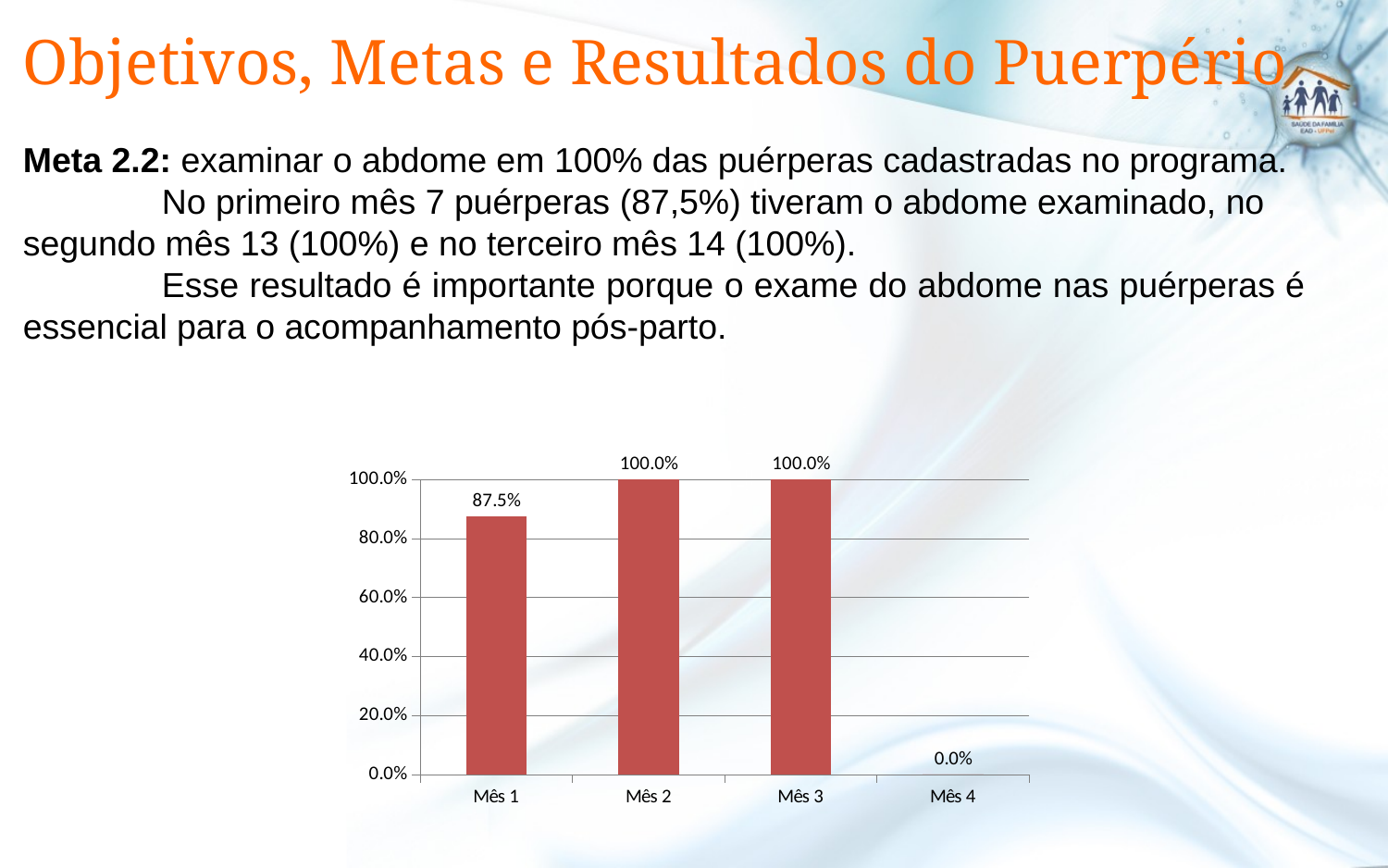
What colour are the bars in the chart? red What is the value for Mês 1? 87.5% Do the values rise or fall from Mês 1 to Mês 2? rise Which is larger, the value for Mês 1 or the value for Mês 3? Mês 3 What is the difference between the values for Mês 2 and Mês 1? 12.5% What kind of chart is shown on the slide? bar chart What is the value for Mês 4? 0.0% Which category has the lowest value? Mês 4 What is the value for Mês 2? 100.0% How many categories are shown on the x axis? 4 What is the highest value shown on the y axis? 100.0% Is the value for Mês 1 greater or less than 80.0%? greater